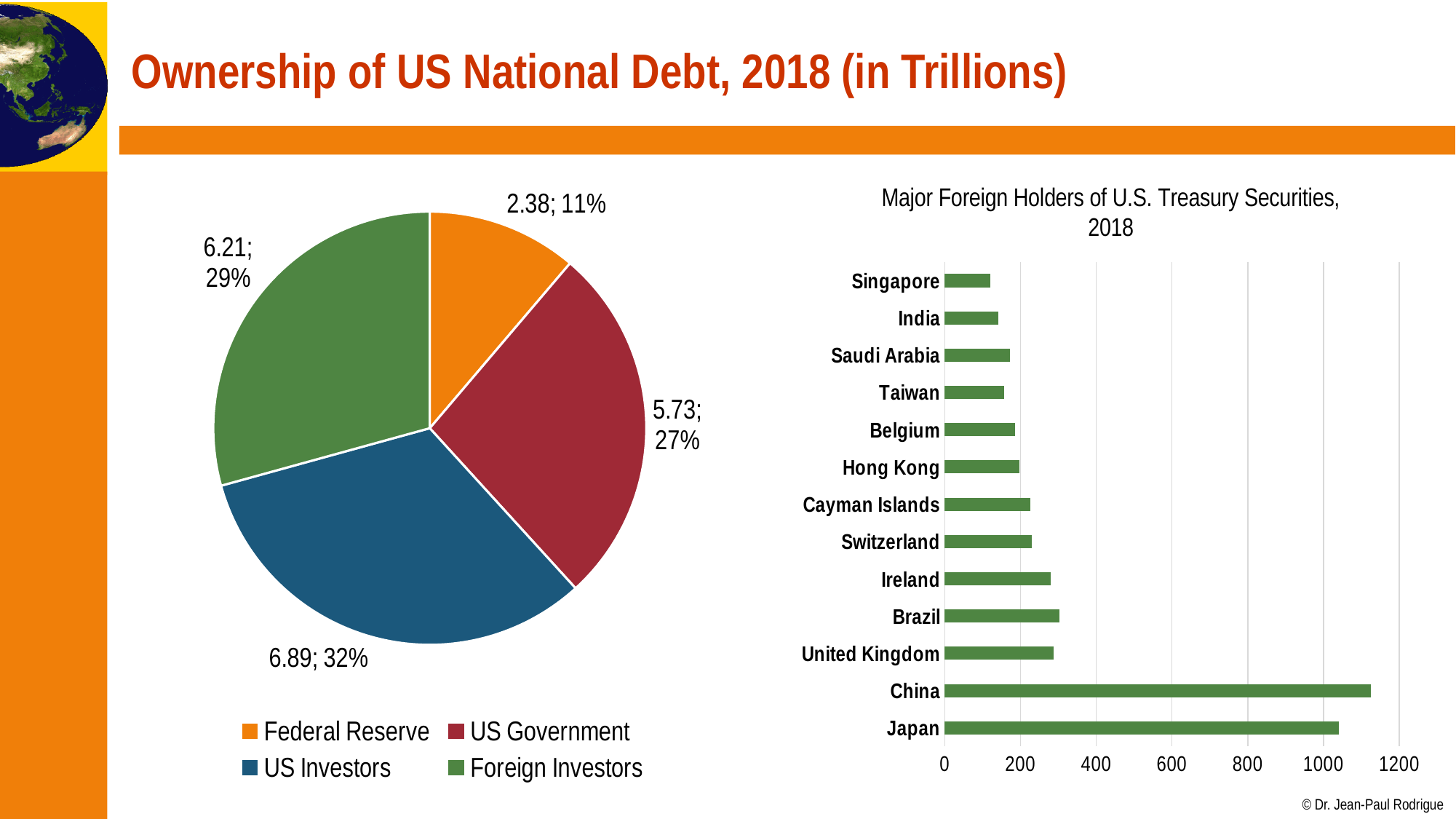
In the chart titled 'Major Foreign Holders of U.S. Treasury Securities, 2018', which country has the highest value? China In the pie chart on the left, which is larger: US Government or Foreign Investors? Foreign Investors In the pie chart on the left, which category has the smallest share? Federal Reserve In the pie chart on the left, what percentage share does Foreign Investors hold? 29% How many countries are shown in the chart titled 'Major Foreign Holders of U.S. Treasury Securities, 2018'? 13 In the pie chart on the left, what value is shown for US Investors? 6.89 In the chart titled 'Major Foreign Holders of U.S. Treasury Securities, 2018', which country has the lowest value? Singapore In the pie chart on the left, which category has the largest share? US Investors In the pie chart on the left, what is the difference between the US Investors value and the Federal Reserve value? 4.51 In the chart titled 'Major Foreign Holders of U.S. Treasury Securities, 2018', is the value for China greater or less than 1000? greater What kind of chart is the one titled 'Major Foreign Holders of U.S. Treasury Securities, 2018'? Bar chart In the pie chart on the left, what value is shown for the Federal Reserve? 2.38